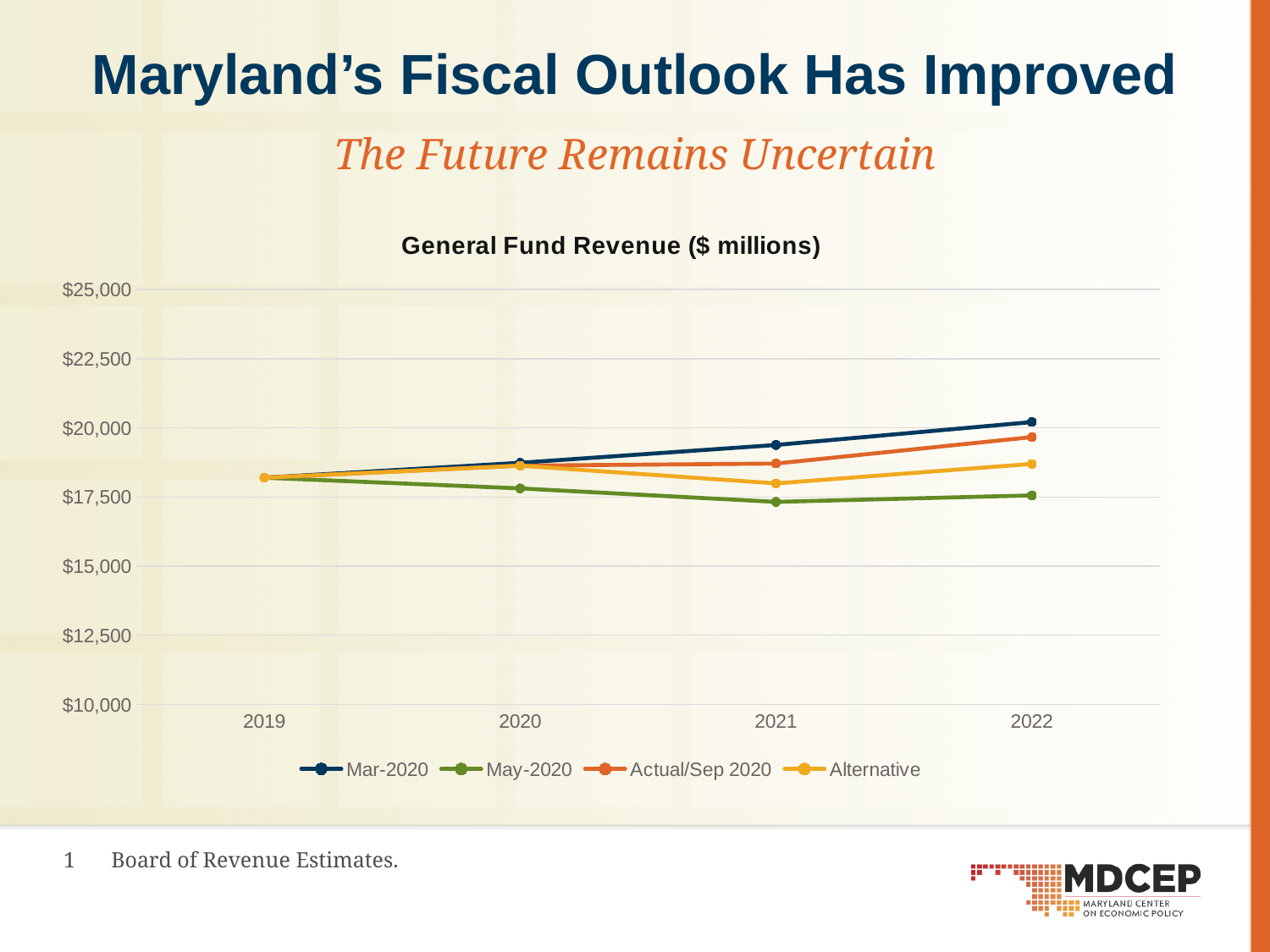
In 2022, which is larger: the Actual/Sep 2020 value or the Alternative value? Actual/Sep 2020 How many years are shown on the x axis of the chart? 4 Is the value for May-2020 in 2021 greater or less than $17,500? less Which series is drawn in green in the chart? May-2020 Does the Mar-2020 series rise or fall from 2019 to 2022? Rise Is the value for Mar-2020 in 2021 greater or less than $20,000? less How many series does the chart legend list? 4 Which series has the highest value in 2022? Mar-2020 What is the title of the chart? General Fund Revenue ($ millions) Which series has the lowest value in 2021? May-2020 What kind of chart is shown on the slide? Line chart Is the value for Actual/Sep 2020 in 2022 greater or less than $20,000? less